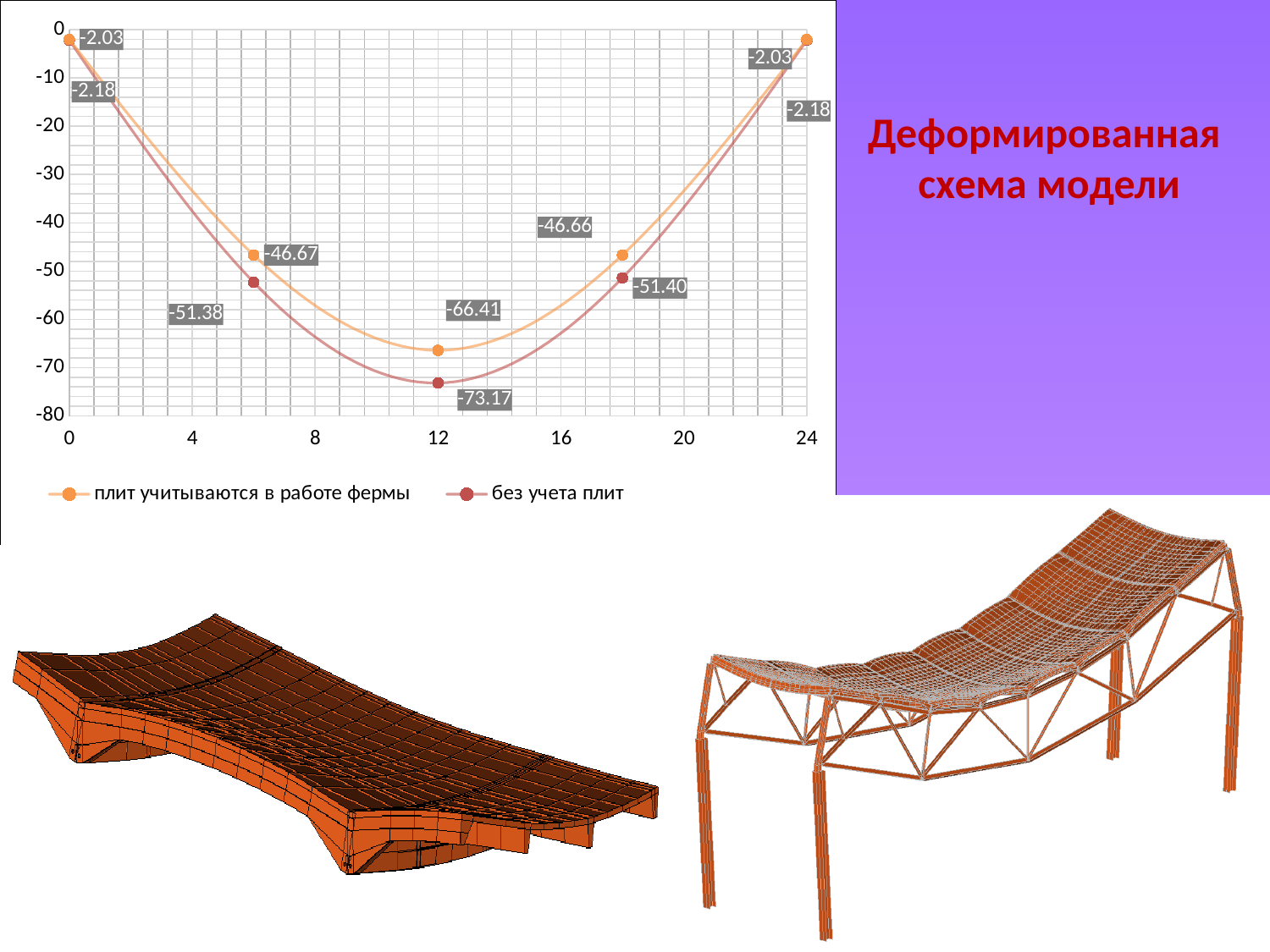
How many series does the chart legend list? 2 What is the value of the series 'плит учитываются в работе фермы' at x = 18? -46.66 What is the value of the series 'без учета плит' at x = 0? -2.18 What kind of chart is shown on the slide? line chart How many data points are plotted for the series 'плит учитываются в работе фермы'? 5 At which x value does the series 'без учета плит' reach its lowest value? 12 What is the value of the series 'плит учитываются в работе фермы' at x = 12? -66.41 What is the value of the series 'без учета плит' at x = 12? -73.17 What is the value of the series 'без учета плит' at x = 6? -51.38 Do the values of the series 'без учета плит' rise or fall from x = 0 to x = 12? fall Which series has the lower value at x = 6: 'плит учитываются в работе фермы' or 'без учета плит'? без учета плит What is the difference between the two series at x = 12 (-66.41 and -73.17)? 6.76